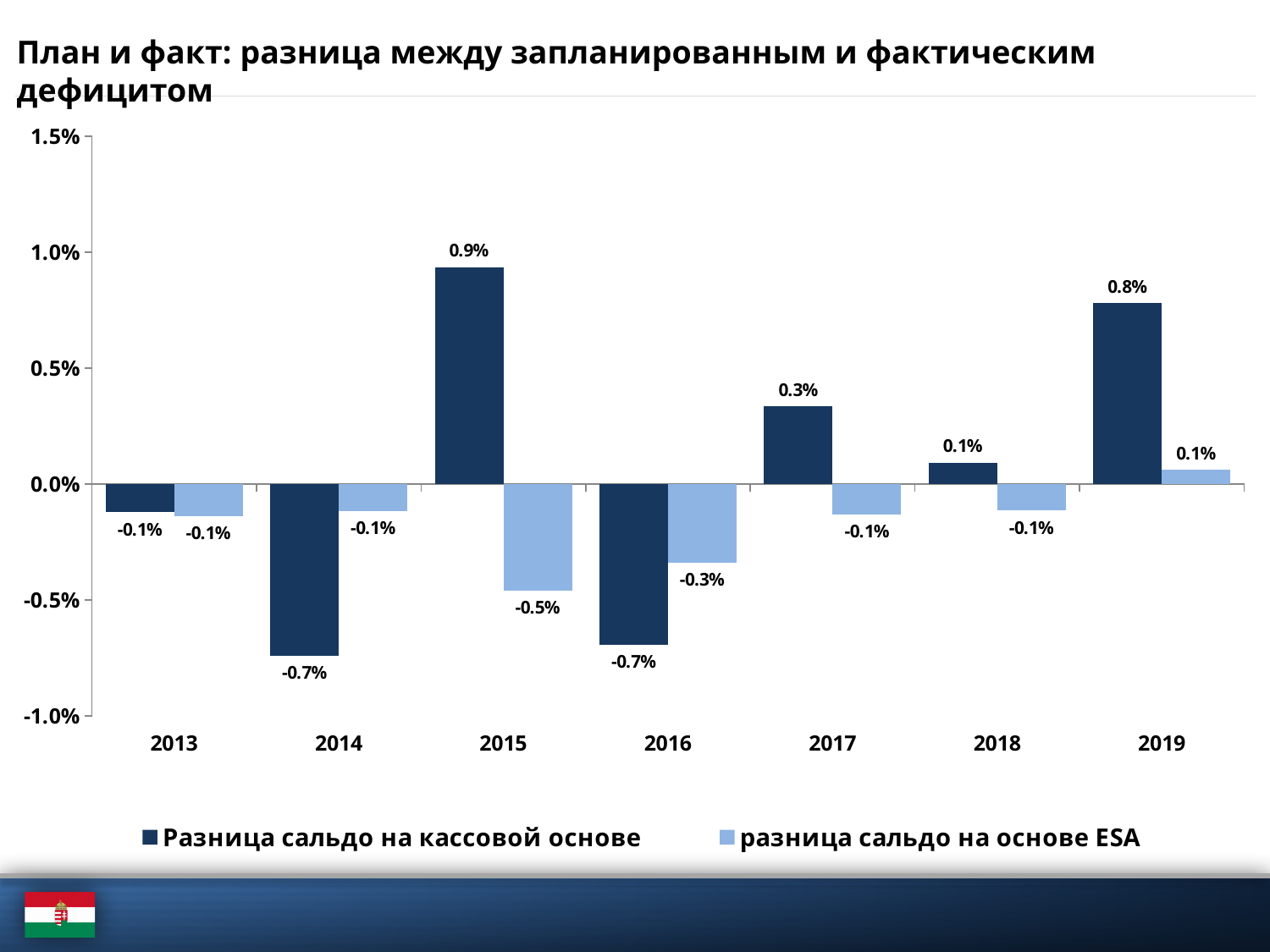
In which year is 'разница сальдо на основе ESA' lowest? 2015 Which is larger in 2017: 'Разница сальдо на кассовой основе' or 'разница сальдо на основе ESA'? Разница сальдо на кассовой основе In which year is 'Разница сальдо на кассовой основе' highest? 2015 How many series does the legend list? 2 What is the value of 'Разница сальдо на кассовой основе' for 2019? 0.8% What is the value of 'разница сальдо на основе ESA' for 2015? -0.5% What is the value of 'разница сальдо на основе ESA' for 2016? -0.3% What kind of chart is shown on the slide? bar chart What is the value of 'Разница сальдо на кассовой основе' for 2015? 0.9% How many years are shown on the x axis? 7 What is the difference between 'Разница сальдо на кассовой основе' in 2015 and in 2019? 0.1% Is the value of 'Разница сальдо на кассовой основе' for 2014 greater or less than -0.5%? less